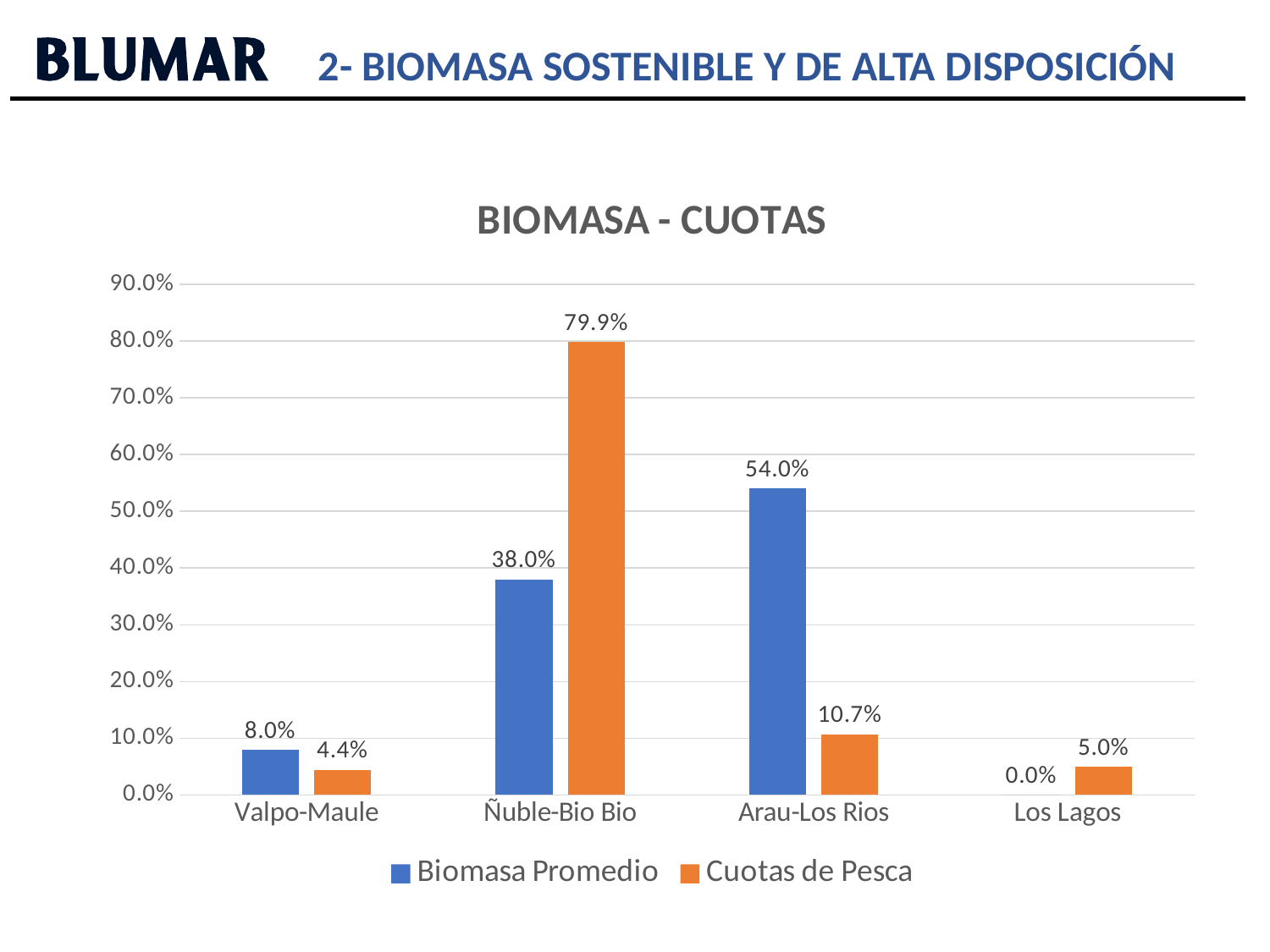
Which category has the lowest Biomasa Promedio value? Los Lagos What is the difference between the Cuotas de Pesca and Biomasa Promedio values for Ñuble-Bio Bio? 41.9% What is the Biomasa Promedio value for Los Lagos? 0.0% Which category has the highest Cuotas de Pesca value? Ñuble-Bio Bio Is the Biomasa Promedio value for Arau-Los Rios greater or less than 50.0%? greater How many series does the legend list? 2 How many categories are shown on the x axis? 4 What is the title of the chart? BIOMASA - CUOTAS What kind of chart is shown on the slide? Bar chart Which is larger for Arau-Los Rios: Biomasa Promedio or Cuotas de Pesca? Biomasa Promedio What is the Cuotas de Pesca value for Arau-Los Rios? 10.7% What is the Biomasa Promedio value for Ñuble-Bio Bio? 38.0%